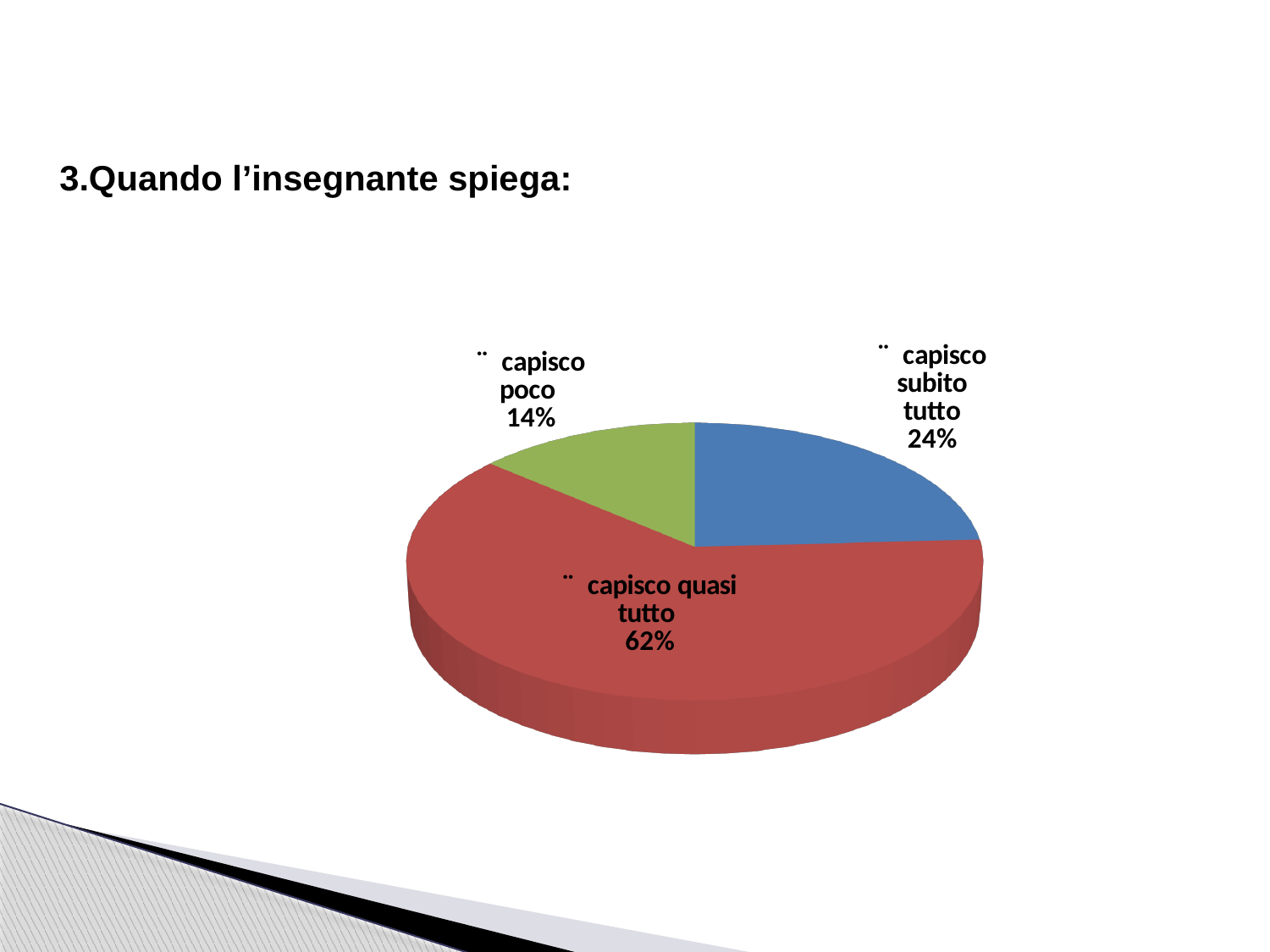
What is the difference in percentage points between "capisco subito tutto" and "capisco poco"? 10 Which category has the smallest share of the pie? capisco poco Which category has the largest share of the pie? capisco quasi tutto What colour is the slice for "capisco quasi tutto"? red Which is larger, the share for "capisco subito tutto" or the share for "capisco poco"? capisco subito tutto What is the title text above the chart? 3.Quando l'insegnante spiega: What percentage is shown for "capisco poco"? 14% How many slices does the pie chart have? 3 What is the difference in percentage points between "capisco quasi tutto" and "capisco subito tutto"? 38 What percentage is shown for "capisco subito tutto"? 24% What kind of chart is shown on the slide? pie chart What percentage is shown for "capisco quasi tutto"? 62%